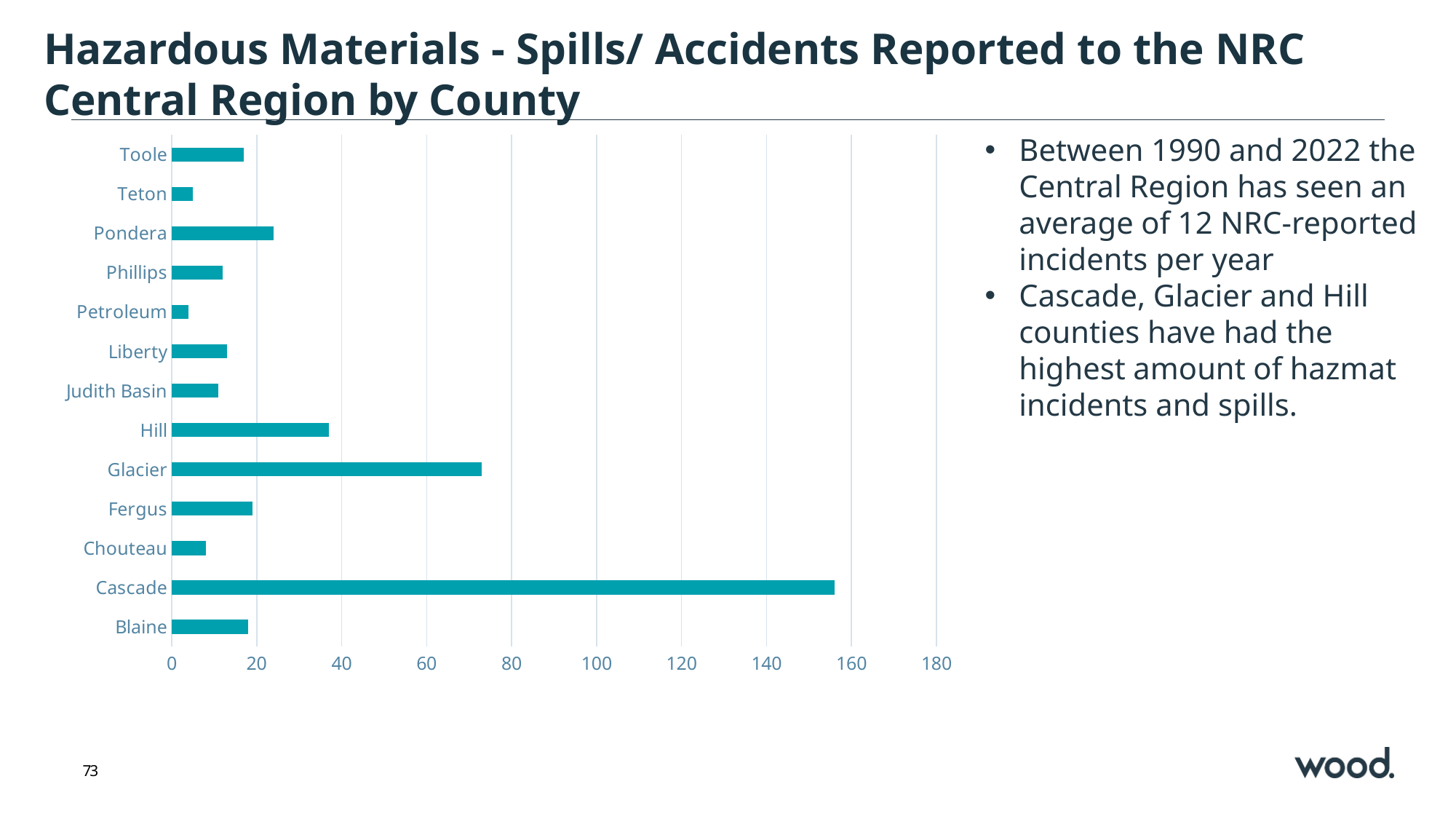
Is the value for Glacier greater or less than 60? greater Is the value for Hill greater or less than 20? greater Which has a larger value, Glacier or Hill? Glacier Is the value for Glacier greater or less than 80? less Which county has the highest number of spills/accidents reported? Cascade Which has a larger value, Pondera or Chouteau? Pondera What is the highest value shown on the horizontal axis of the chart? 180 What kind of chart is shown on the slide? bar chart How many counties are shown on the chart? 13